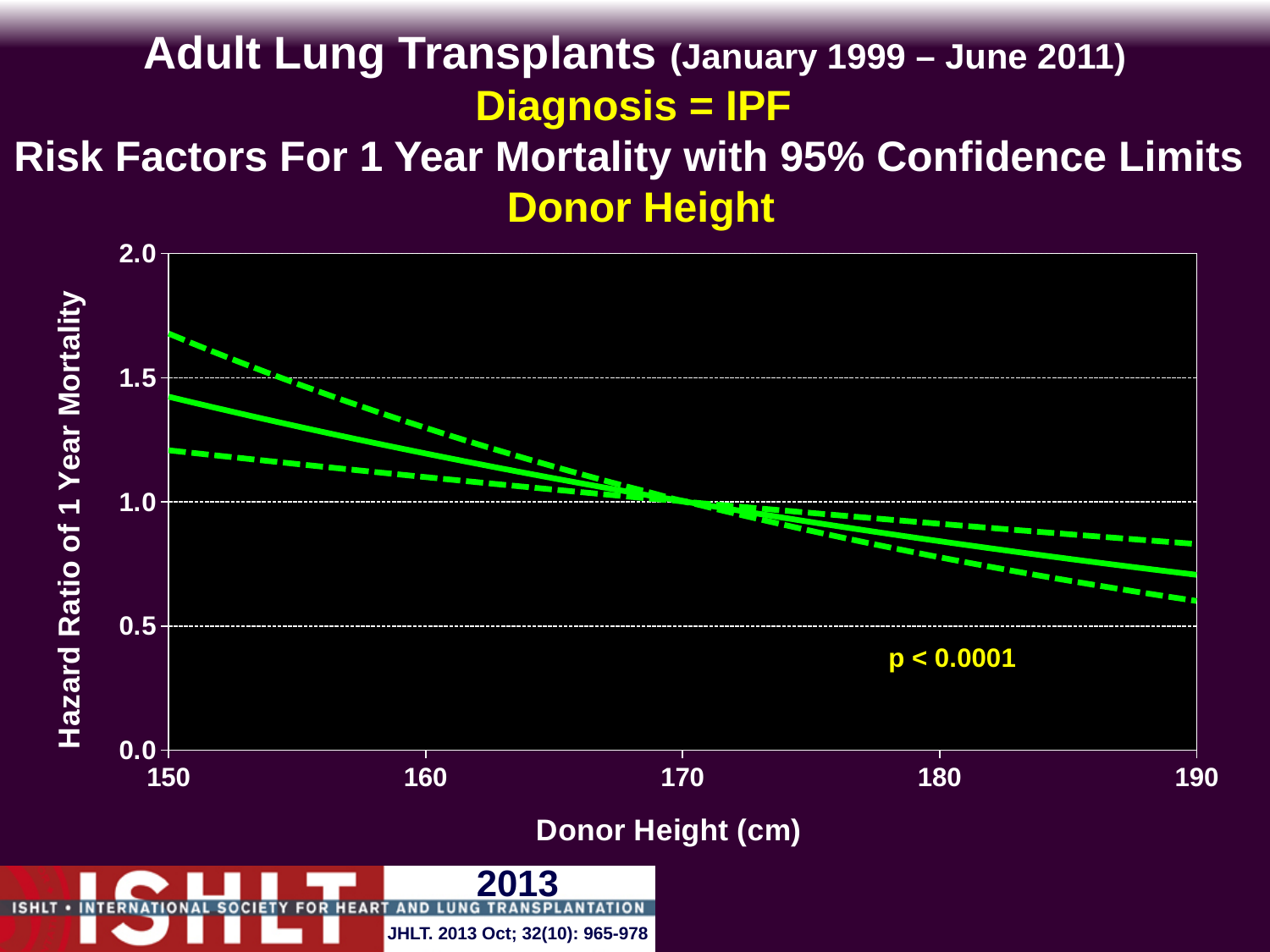
At which donor height tick on the x axis does the hazard ratio (solid line) cross 1.0? 170 What kind of chart is shown on the slide? line chart Is the hazard ratio (solid line) at a donor height of 190 cm greater or less than 1.0? less Does the hazard ratio of 1 year mortality rise or fall as donor height increases from 150 cm to 190 cm? fall Is the lower 95% confidence limit (lower dashed line) at a donor height of 190 cm greater or less than 0.5? greater Is the hazard ratio (solid line) at a donor height of 150 cm greater or less than 1.0? greater What is the label of the x axis? Donor Height (cm) How many lines are plotted on the chart? 3 What p-value is printed on the chart? p < 0.0001